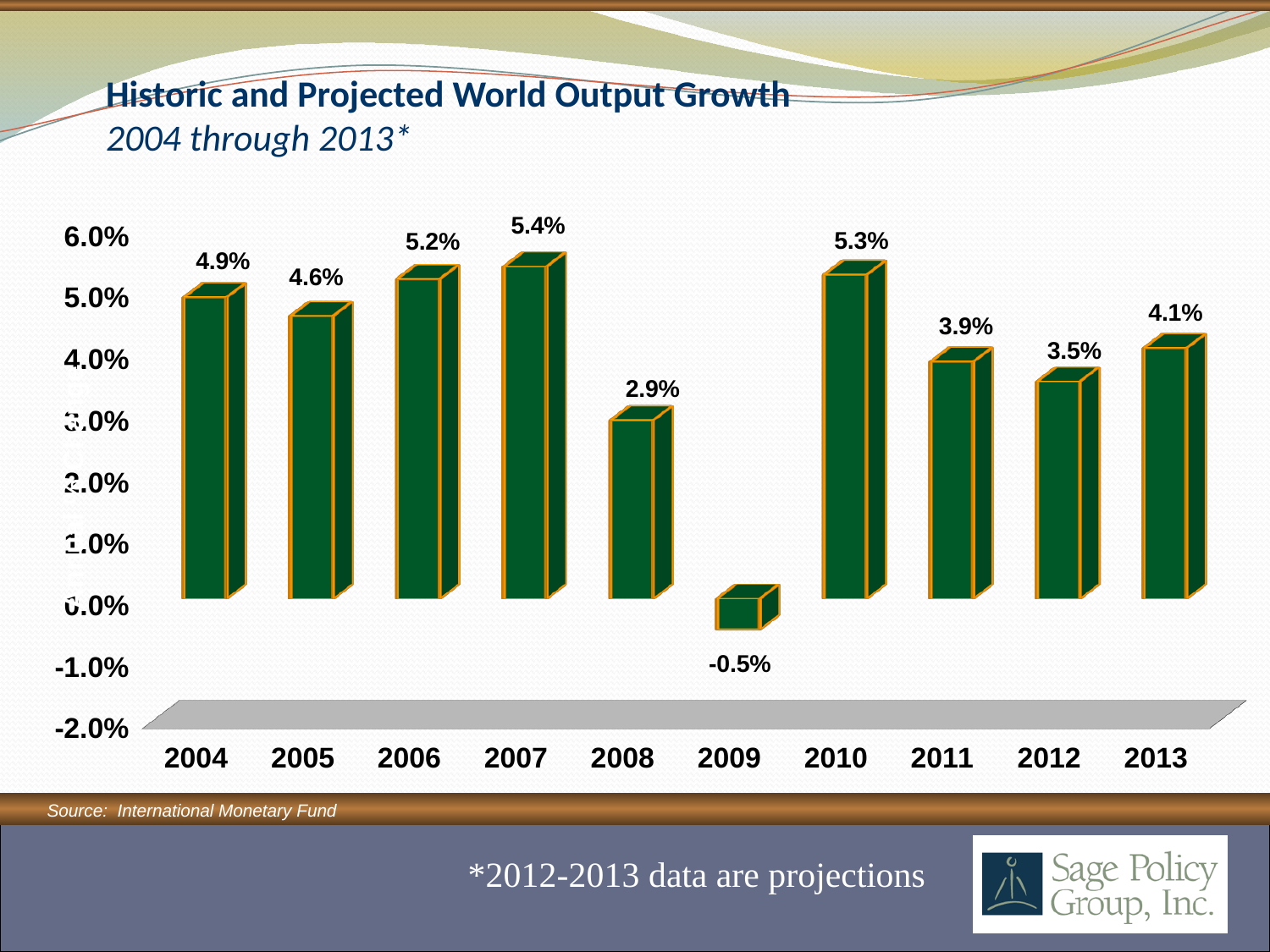
Which year had higher world output growth, 2004 or 2005? 2004 What is the difference between world output growth in 2010 and 2011? 1.4% What was world output growth in 2009? -0.5% What is the source of the data shown on the chart? International Monetary Fund How many years are shown on the chart? 10 What was world output growth in 2007? 5.4% Is the value for 2008 greater or less than 3.0%? less Which year has the highest world output growth? 2007 What is the projected world output growth for 2013? 4.1% Did world output growth rise or fall from 2007 to 2009? fall What kind of chart is shown on the slide? bar chart Which year has the lowest world output growth? 2009